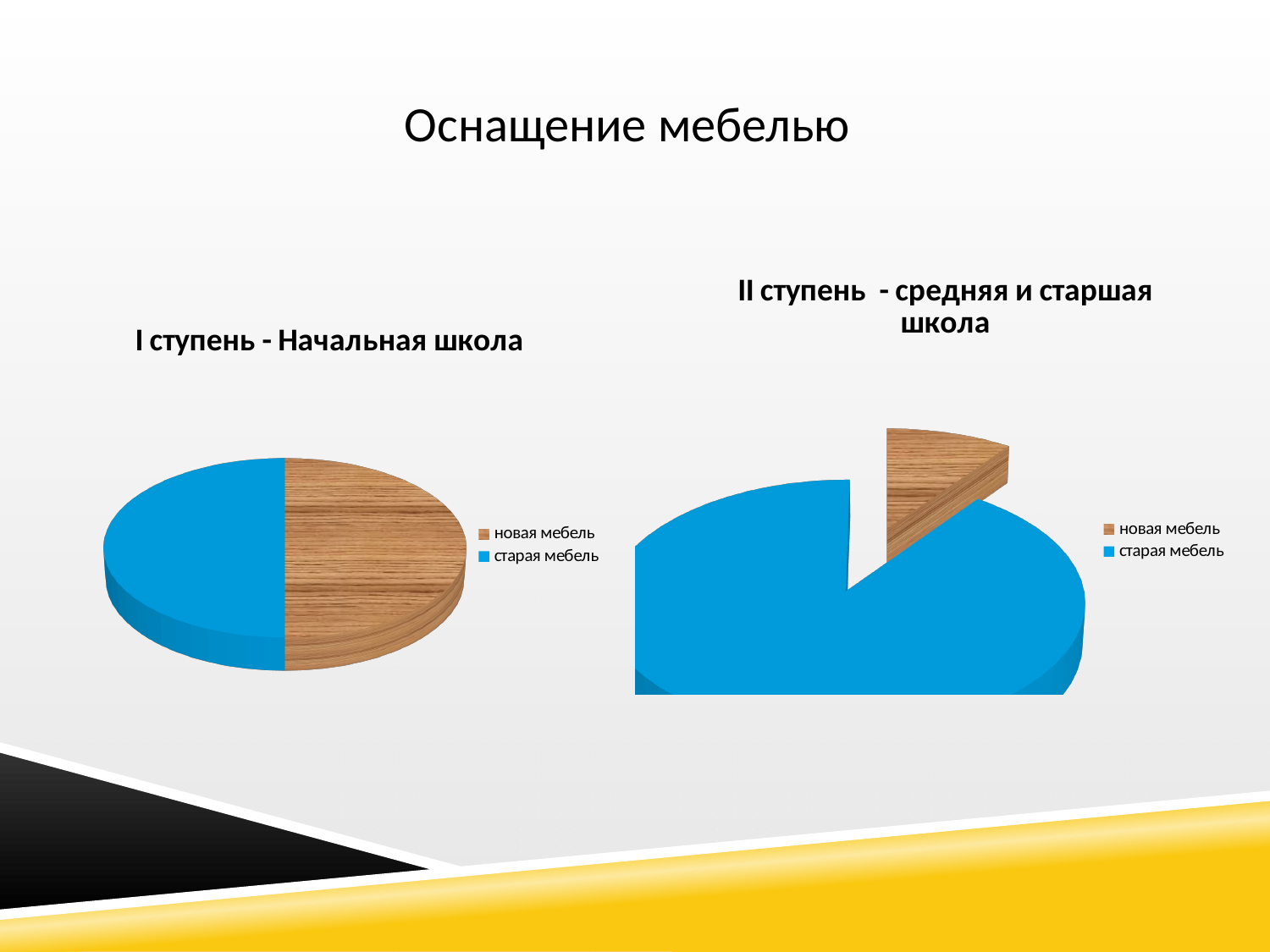
What are the two legend entries of the "I ступень - Начальная школа" chart? новая мебель, старая мебель How many entries does the legend of the "II ступень - средняя и старшая школа" chart list? 2 What kind of chart is the "I ступень - Начальная школа" chart? pie chart How many slices does the "I ступень - Начальная школа" pie chart have? 2 In the "II ступень - средняя и старшая школа" chart, which slice is the largest? старая мебель What kind of chart is the "II ступень - средняя и старшая школа" chart? pie chart In the "II ступень - средняя и старшая школа" chart, which is larger: новая мебель or старая мебель? старая мебель In the "II ступень - средняя и старшая школа" chart, what colour is the старая мебель slice? blue In the "II ступень - средняя и старшая школа" chart, which slice is the smallest? новая мебель How many slices does the "II ступень - средняя и старшая школа" pie chart have? 2